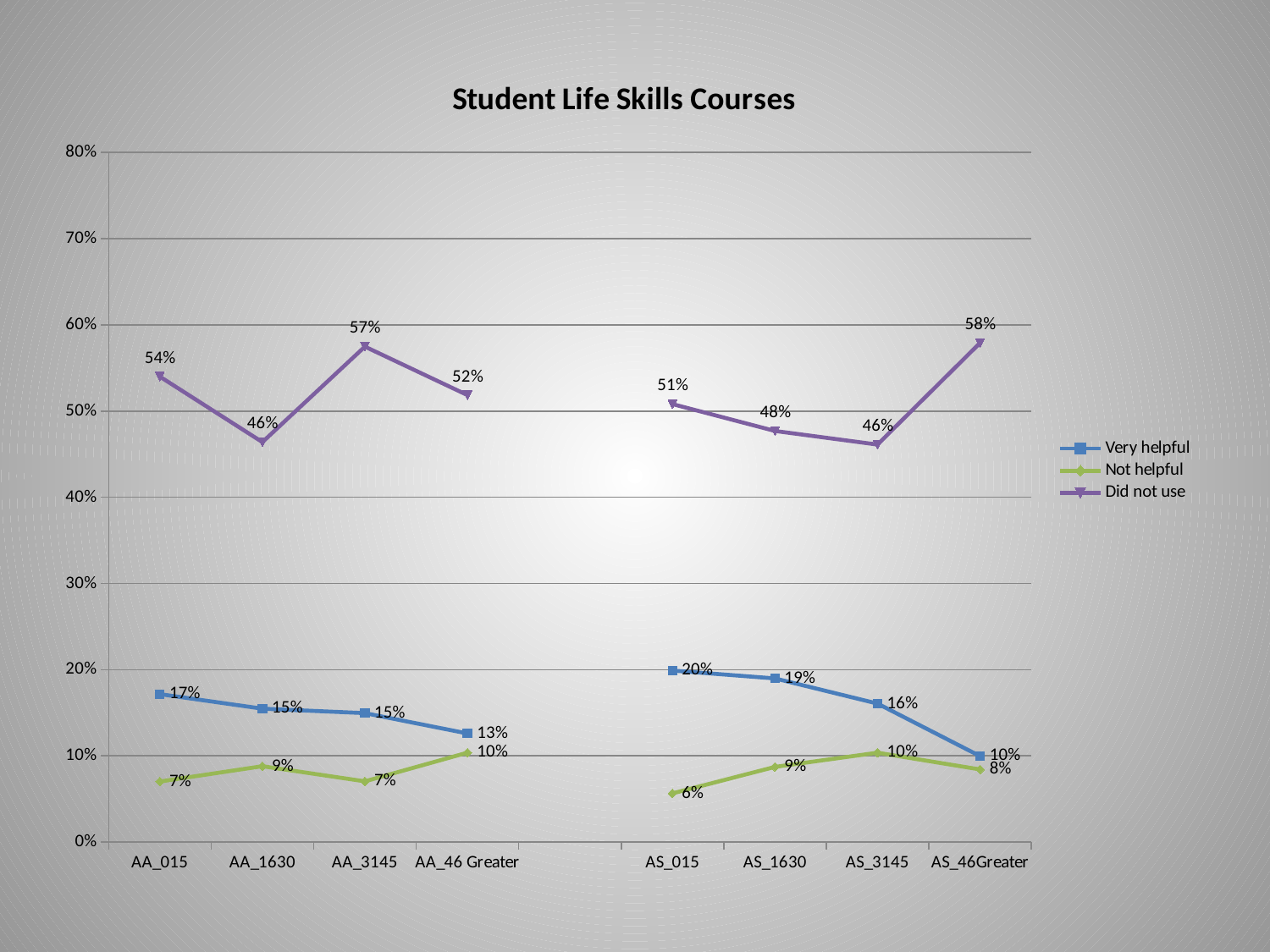
What type of chart is shown on the slide? line chart What is the 'Not helpful' value for AS_46Greater? 8% What is the 'Very helpful' value for AS_015? 20% How many category labels appear on the x axis? 8 What is the 'Did not use' value for AA_3145? 57% What is the title of the chart? Student Life Skills Courses Which category has the highest 'Did not use' value? AS_46Greater How many series does the legend list? 3 Does the 'Very helpful' series rise or fall from AS_015 to AS_46Greater? fall What is the difference between the 'Very helpful' values for AS_015 and AS_46Greater? 10% Which category has the lowest 'Not helpful' value? AS_015 Which is larger, the 'Did not use' value for AA_015 or for AS_015? AA_015